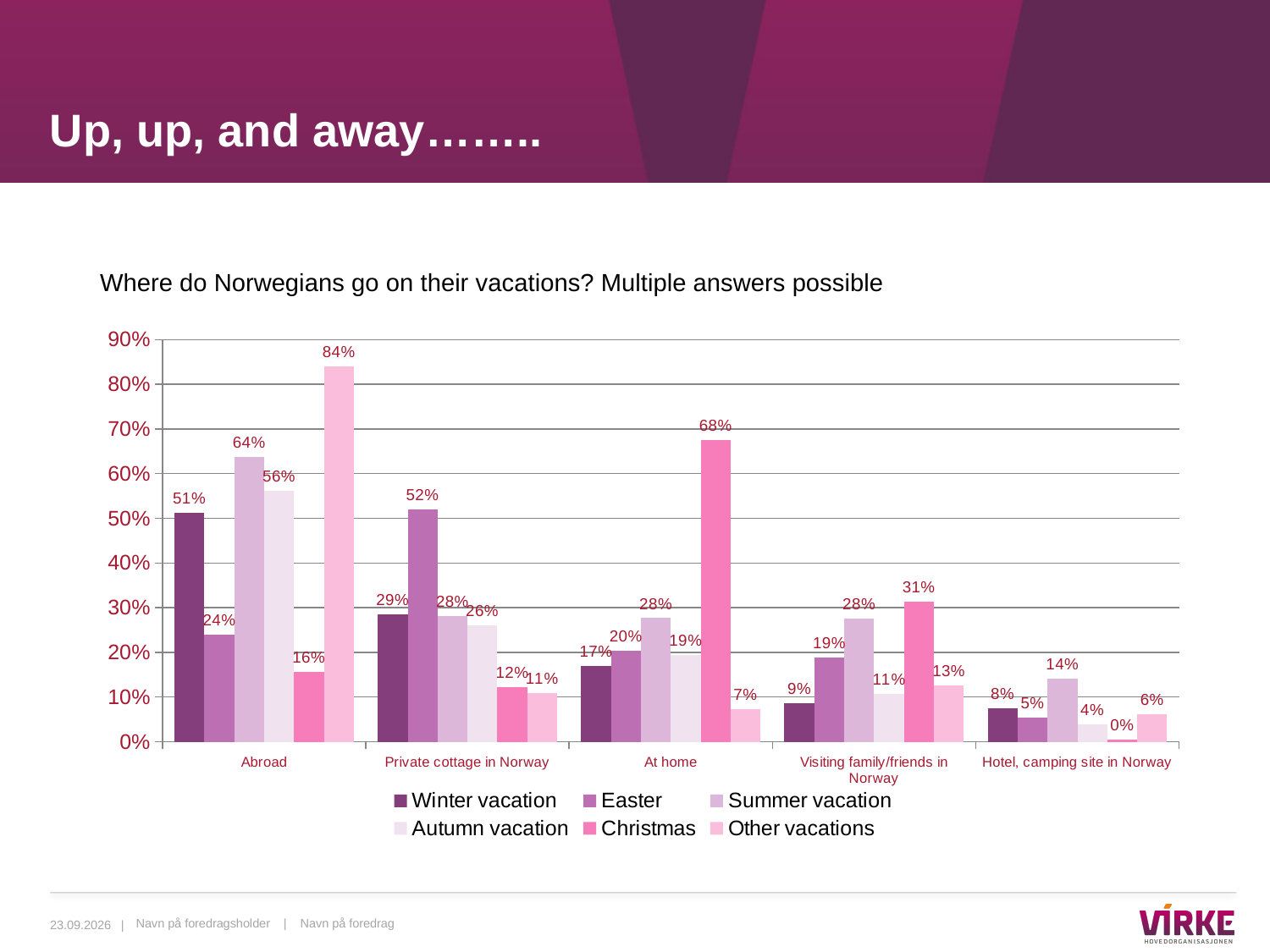
What is the value for Christmas in the Hotel, camping site in Norway category? 0% Which category has the highest value for Summer vacation? Abroad How many series does the legend list? 6 What kind of chart is shown on the slide? Bar chart What is the difference between the Summer vacation and Easter values in the Abroad category? 40% What is the value for Easter in the Private cottage in Norway category? 52% What is the value for Other vacations in the Abroad category? 84% What question does the chart's title ask? Where do Norwegians go on their vacations? Multiple answers possible What is the value for Christmas in the At home category? 68% Which category has the lowest value for Winter vacation? Hotel, camping site in Norway How many categories are shown on the x axis? 5 In the Visiting family/friends in Norway category, which is larger: Christmas or Summer vacation? Christmas